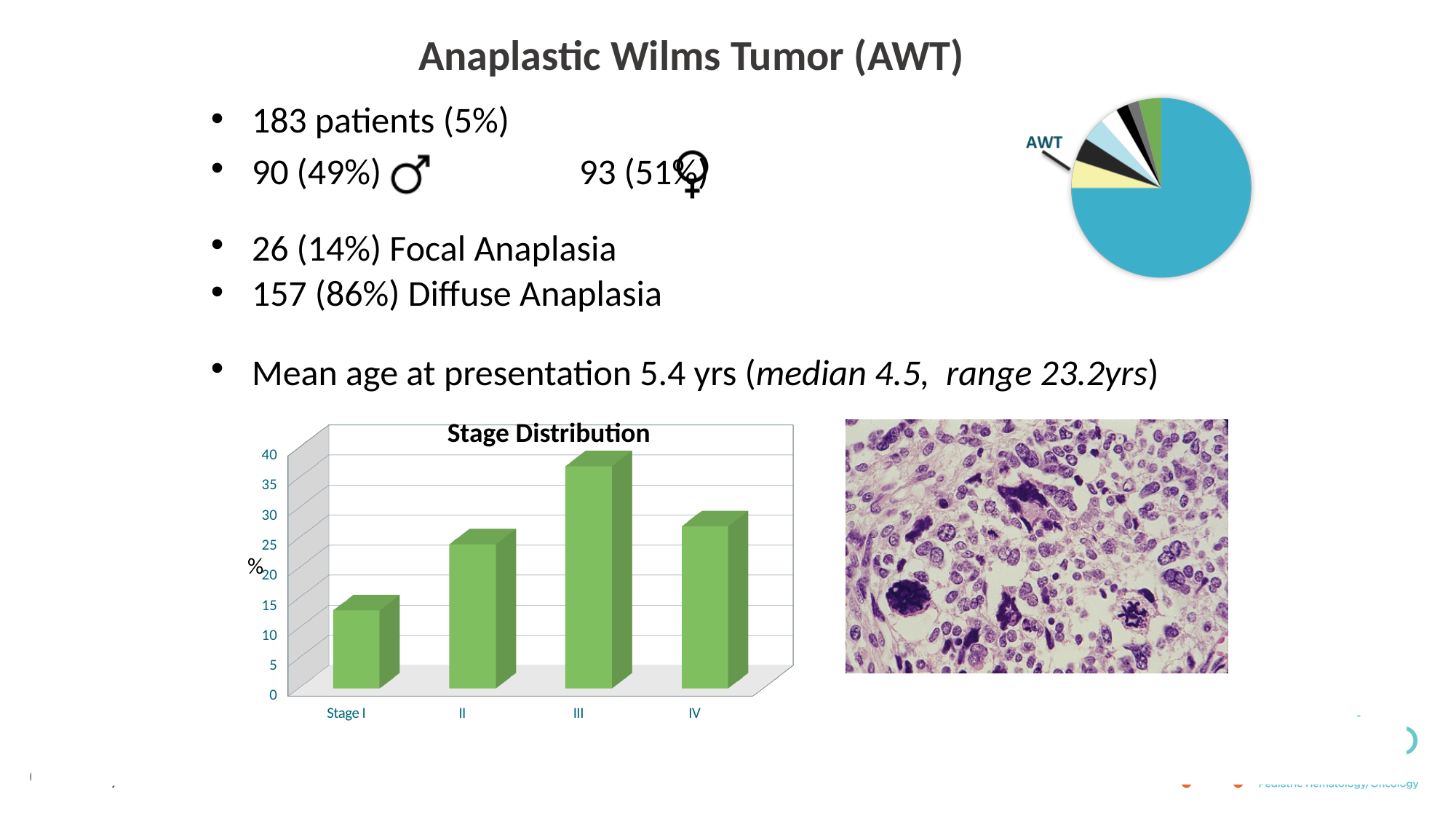
In the Stage Distribution chart, which is larger, the value for Stage II or Stage III? Stage III In the Stage Distribution chart, is the value for Stage IV greater or less than 20? greater In the Stage Distribution chart, do the values rise or fall from Stage I to Stage III? rise In the Stage Distribution chart, which is larger, the value for Stage I or Stage IV? Stage IV In the Stage Distribution chart, is the value for Stage III greater or less than 35? greater How many stage categories are shown in the Stage Distribution chart? 4 What is the label on the vertical axis of the Stage Distribution chart? % In the Stage Distribution chart, which stage has the highest value? III In the Stage Distribution chart, is the value for Stage I greater or less than 15? less What kind of chart is the Stage Distribution chart? bar chart In the Stage Distribution chart, which stage has the lowest value? Stage I